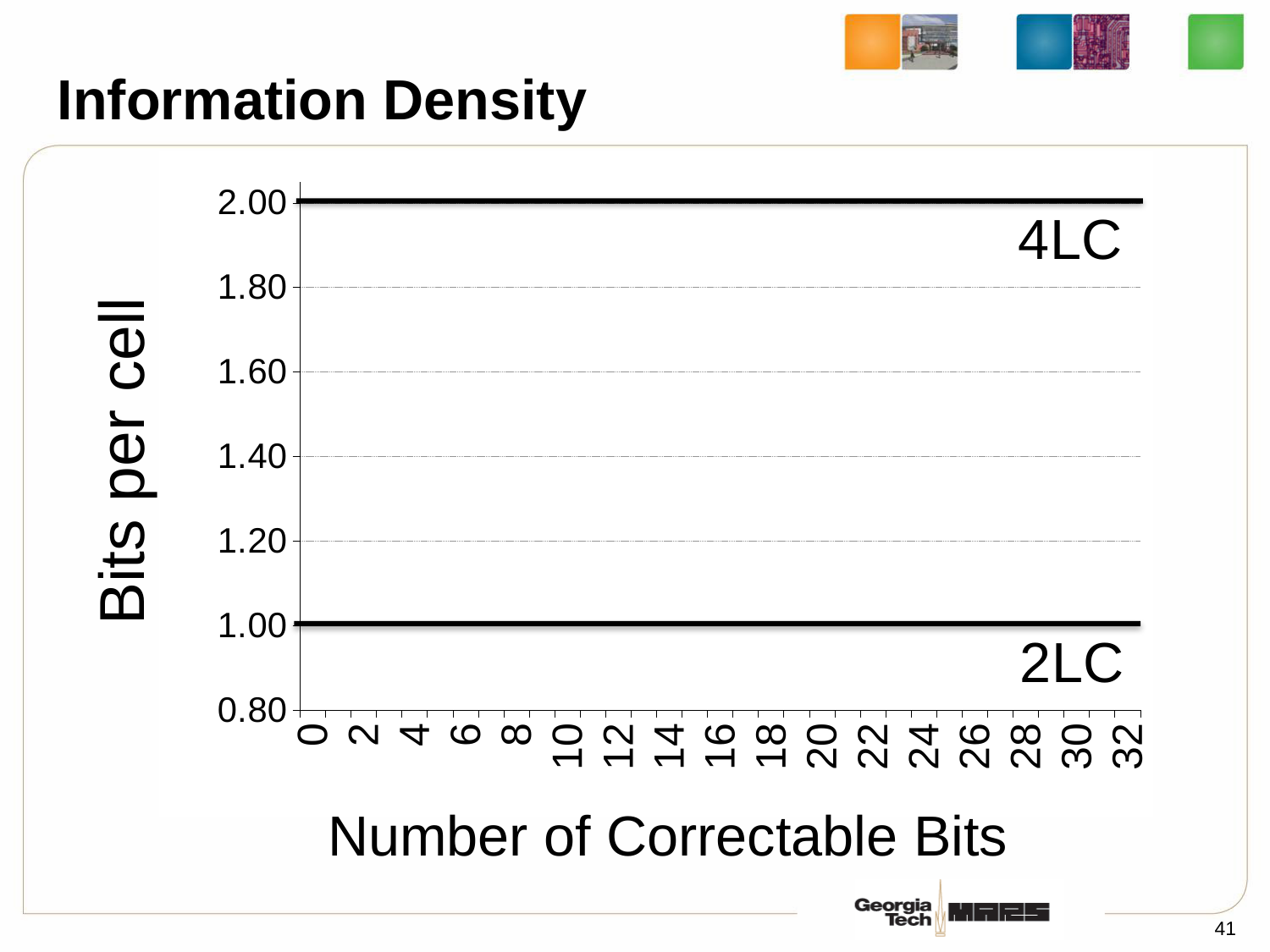
What is the bits per cell value for the 2LC line? 1.00 What is the difference in bits per cell between the 4LC line and the 2LC line? 1.00 How many lines are plotted on the chart? 2 Is the bits per cell value for 2LC greater or less than 1.20? less Which line has the lowest bits per cell? 2LC What is the label of the x axis? Number of Correctable Bits What is the bits per cell value for the 4LC line? 2.00 Is the bits per cell value for 4LC greater or less than 1.80? greater What is the label of the y axis? Bits per cell How does the bits per cell value for 4LC change as the number of correctable bits increases from 0 to 32? It stays constant Which line has the higher bits per cell, 4LC or 2LC? 4LC What kind of chart is shown on the slide? line chart